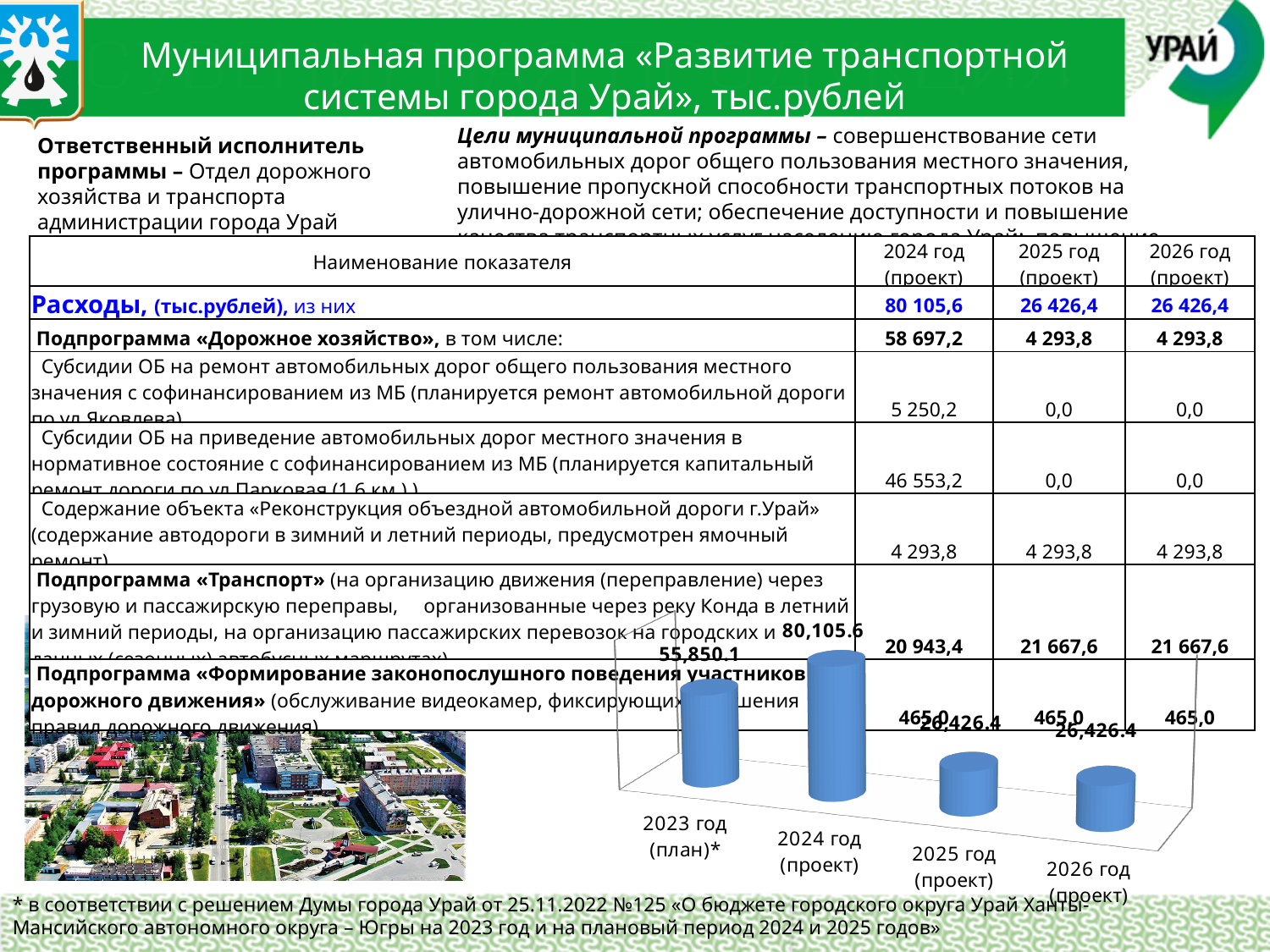
Do the values in the bar chart rise or fall from 2024 год (проект) to 2025 год (проект)? fall What is the difference between the values for 2024 год (проект) and 2023 год (план)* in the bar chart? 24,255.5 What is the value shown for 2025 год (проект) in the bar chart? 26,426.4 What is the difference between the values for 2024 год (проект) and 2025 год (проект) in the bar chart? 53,679.2 Which year has the highest value in the bar chart? 2024 год (проект) What kind of chart is shown at the bottom of the slide? bar chart What is the value shown for 2026 год (проект) in the bar chart? 26,426.4 What is the value shown for 2024 год (проект) in the bar chart? 80,105.6 Are the values for 2025 год (проект) and 2026 год (проект) in the bar chart the same or different? the same What is the value shown for 2023 год (план)* in the bar chart? 55,850.1 How many categories (years) are plotted in the bar chart? 4 Which is larger in the bar chart: the value for 2023 год (план)* or for 2024 год (проект)? 2024 год (проект)